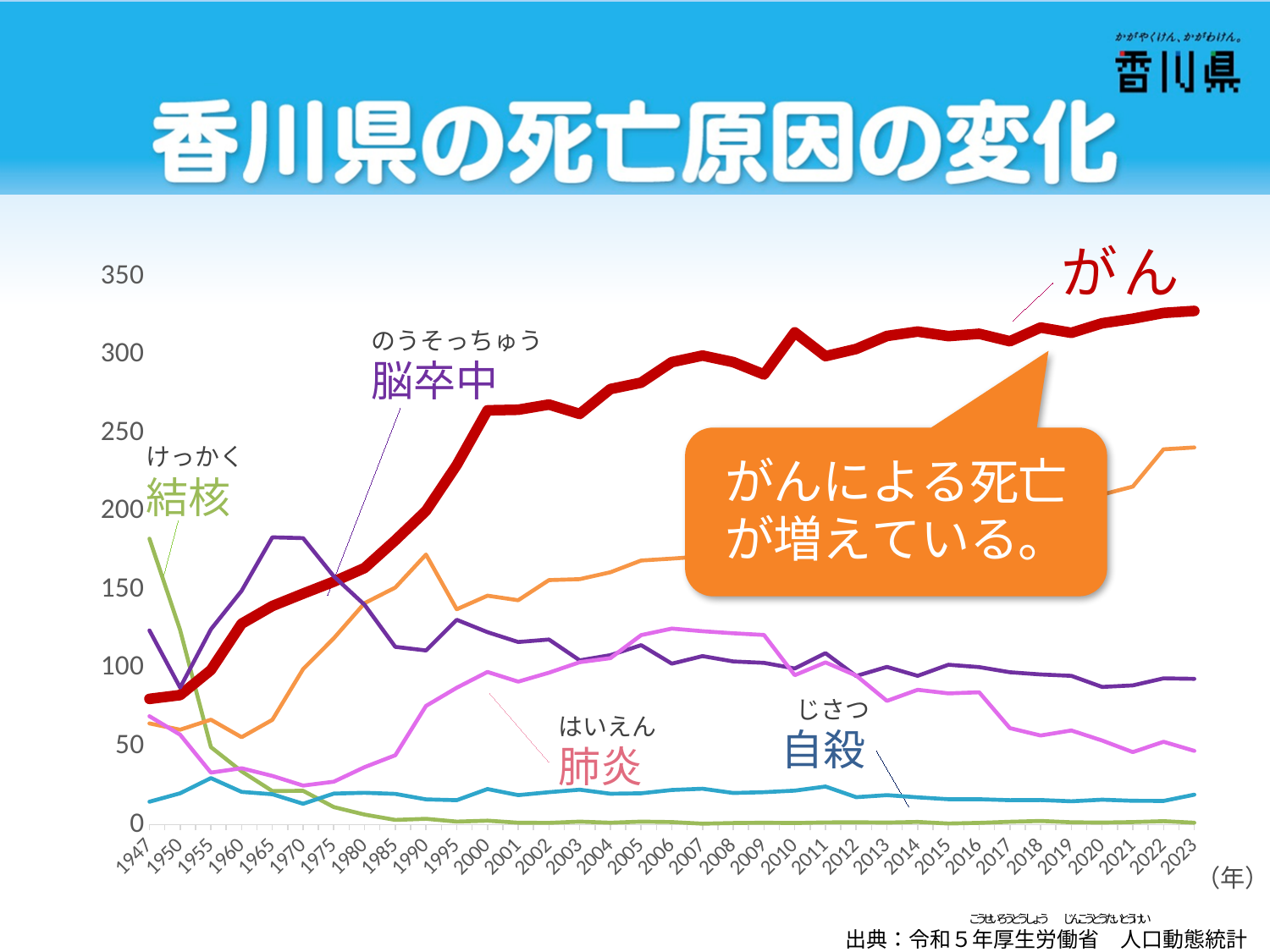
Is the value for 脳卒中 in 1965 greater or less than 150? greater Does the value for がん rise or fall from 1947 to 2023? rise Is the value for 肺炎 in 2006 greater or less than 100? greater Is the value for 結核 in 1947 greater or less than 150? greater Which cause of death has the lowest value in 2023? 結核 What kind of chart is shown on the slide? line chart Which cause of death has the highest value in 2023? がん What is the title of the chart on the slide? 香川県の死亡原因の変化 In 1947, which is larger: the value for 結核 or the value for がん? 結核 Does the value for 結核 rise or fall from 1947 to 2023? fall